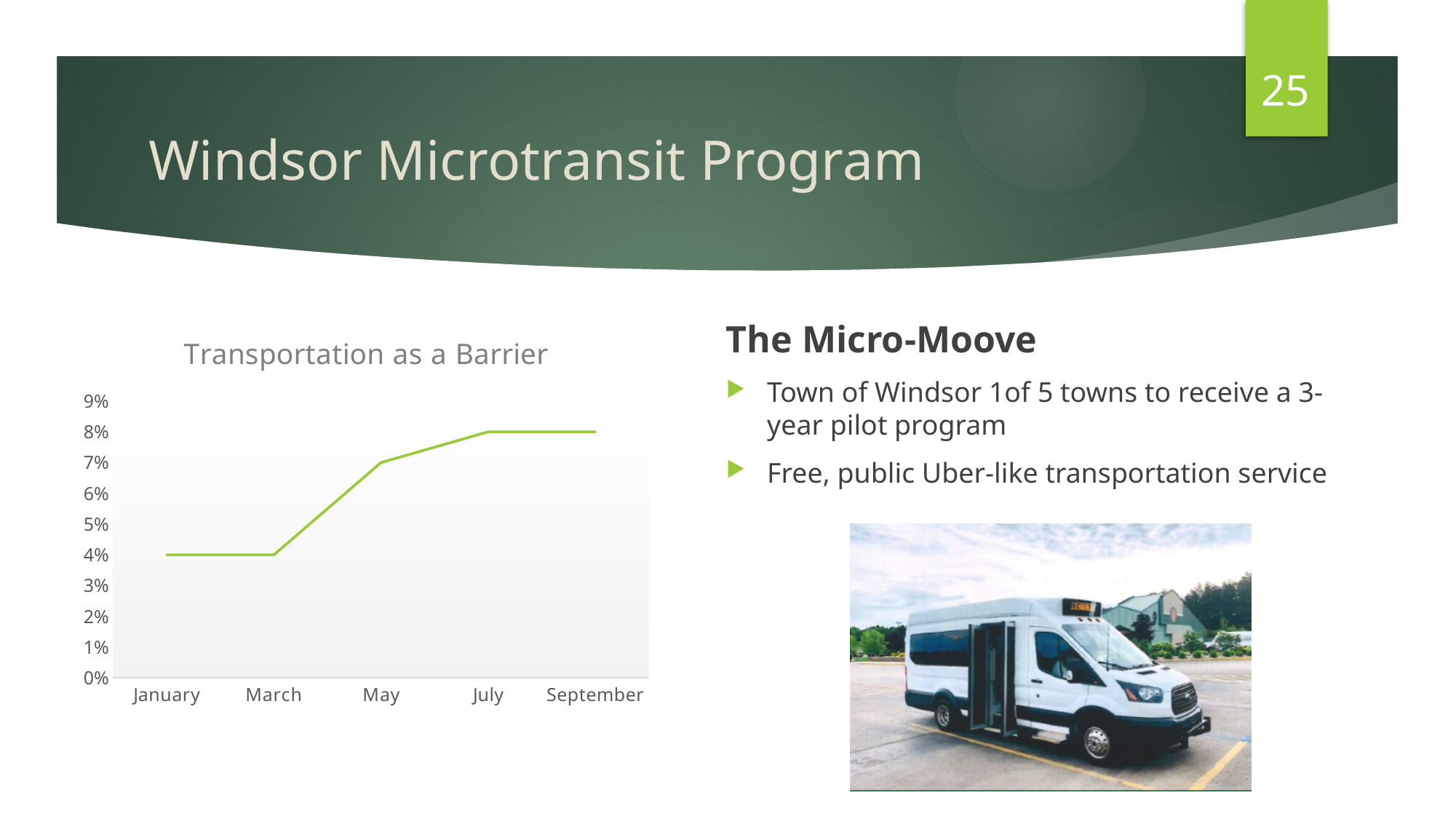
What kind of chart is "Transportation as a Barrier"? line chart How many months are labelled on the x axis of the "Transportation as a Barrier" chart? 5 What is the value for January in the "Transportation as a Barrier" chart? 4% What is the difference between the values for July and March in the "Transportation as a Barrier" chart? 4% Do the values in the "Transportation as a Barrier" chart rise or fall from January to September? rise What is the title of the chart on the slide? Transportation as a Barrier What is the value for May in the "Transportation as a Barrier" chart? 7% Is the value for September in the "Transportation as a Barrier" chart greater or less than 5%? greater Which month has the lowest value in the "Transportation as a Barrier" chart, January or May? January What is the value for July in the "Transportation as a Barrier" chart? 8% What is the value for March in the "Transportation as a Barrier" chart? 4% Which is larger in the "Transportation as a Barrier" chart, the value for May or the value for March? May